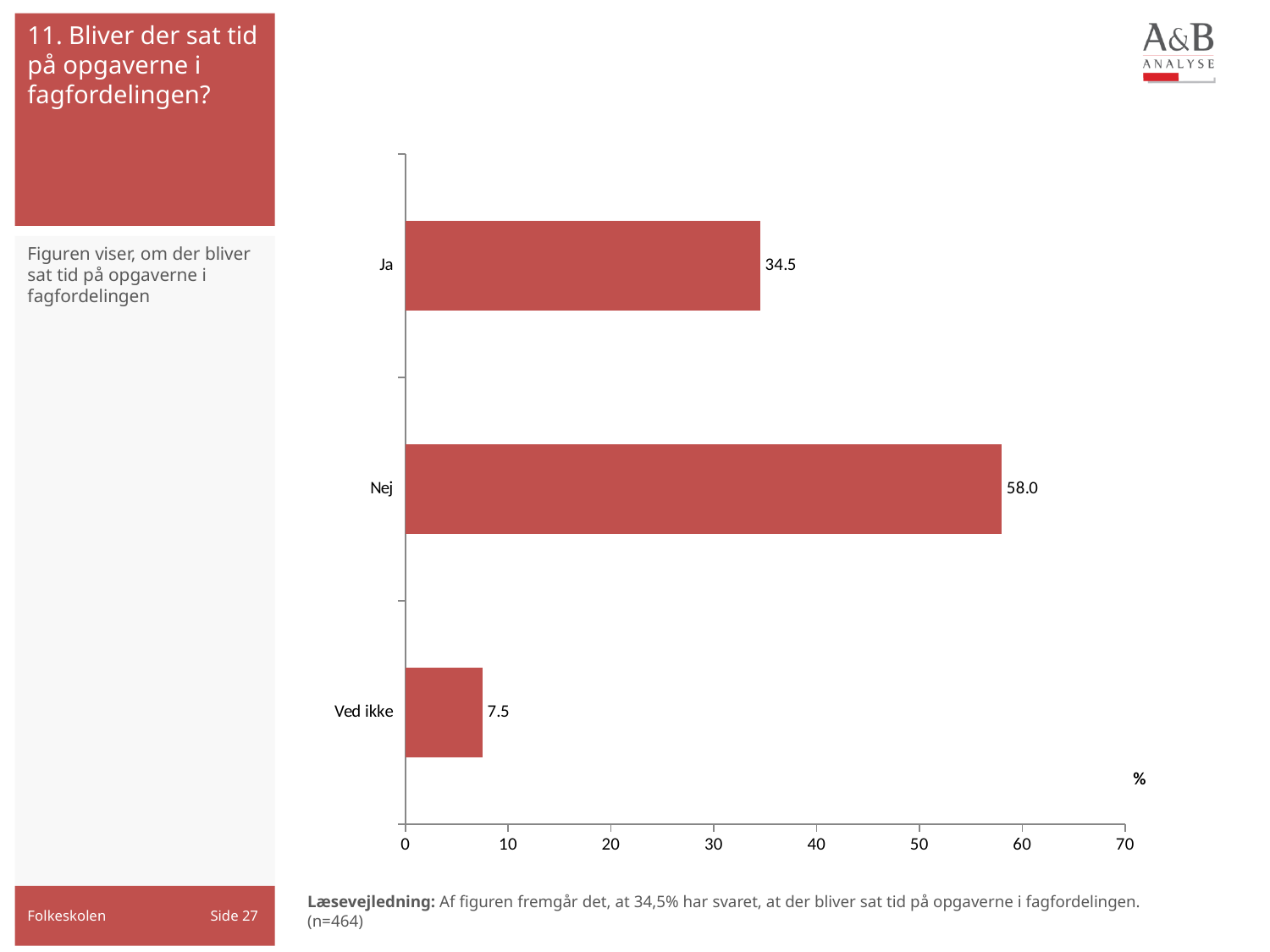
What kind of chart is shown on the slide? bar chart What is the maximum value shown on the x axis? 70 What is the value for "Ved ikke"? 7.5 Which category has the highest value? Nej How many categories are shown in the chart? 3 Which category has the lowest value? Ved ikke Which is larger, the value for "Ja" or the value for "Nej"? Nej What is the difference between the values for "Nej" and "Ja"? 23.5 What is the value for "Ja"? 34.5 What is the value for "Nej"? 58.0 What is the difference between the values for "Ja" and "Ved ikke"? 27.0 Is the value for "Nej" greater or less than 50? greater